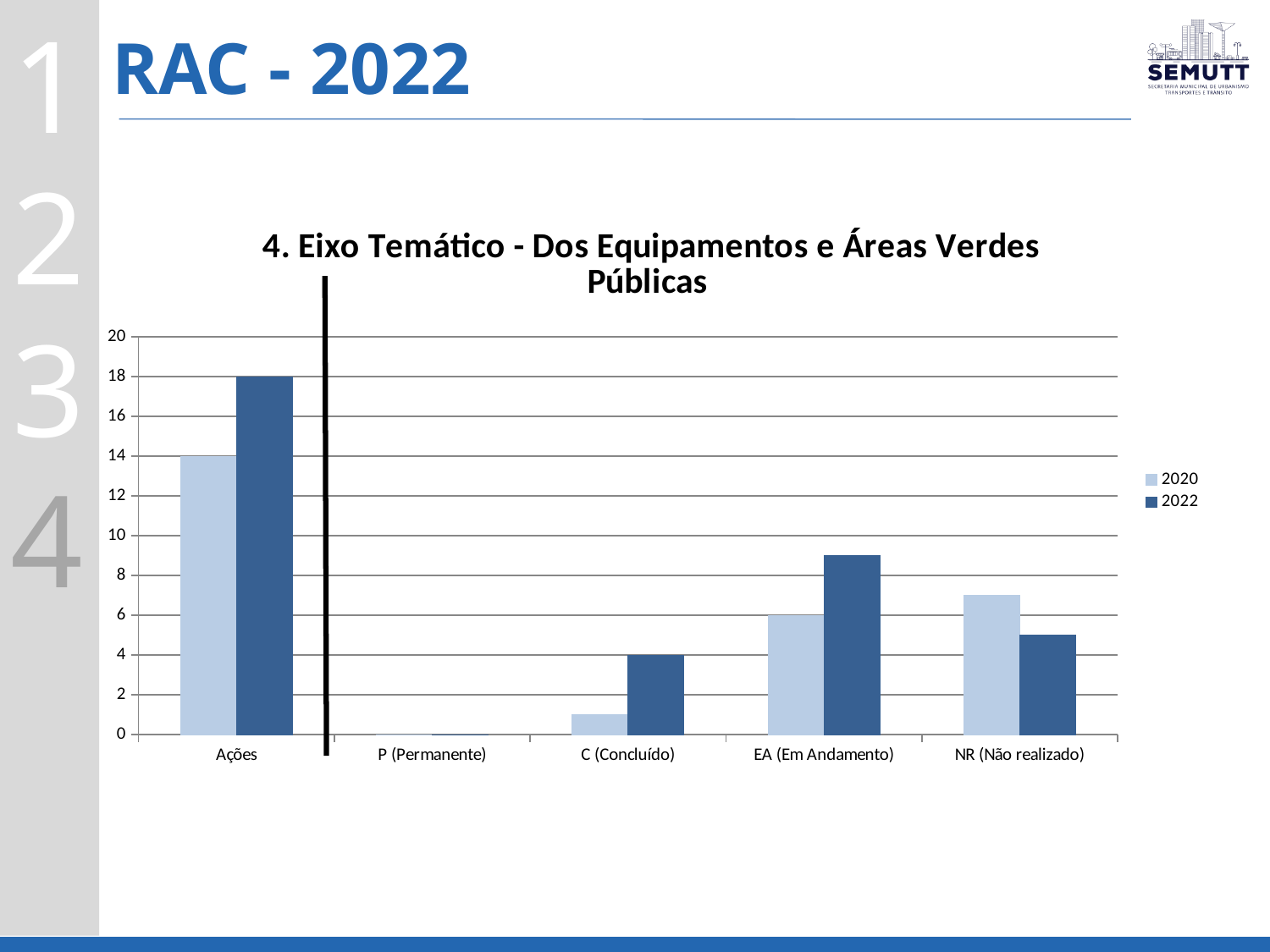
For NR (Não realizado), which series has the larger value, 2020 or 2022? 2020 Which category has the highest value in the 2022 series? Ações What is the value for Ações in the 2020 series? 14 What is the difference between the 2022 and 2020 values for Ações? 4 What type of chart is shown on the slide? bar chart How many series does the legend list? 2 What is the title of the chart? 4. Eixo Temático - Dos Equipamentos e Áreas Verdes Públicas What is the value for C (Concluído) in the 2022 series? 4 What is the value for EA (Em Andamento) in the 2020 series? 6 How many categories are shown on the x axis? 5 Is the 2022 value for EA (Em Andamento) greater or less than 8? greater What is the value for Ações in the 2022 series? 18